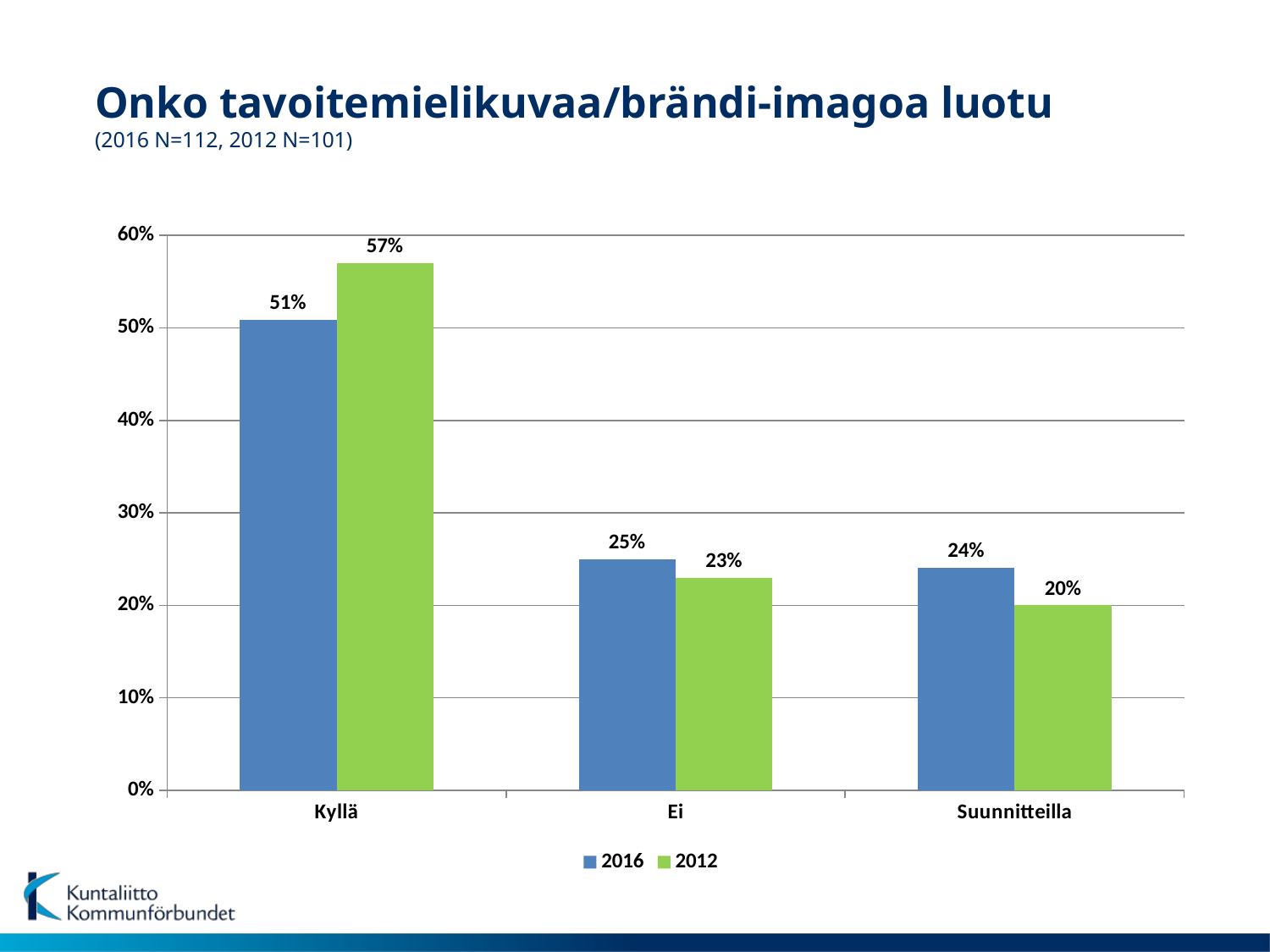
What is the value for Suunnitteilla in the 2012 series? 20% What is the value for Ei in the 2016 series? 25% Which category has the highest value in the 2016 series? Kyllä What is the value for Kyllä in the 2016 series? 51% How many categories are shown on the x axis? 3 What is the difference between the 2012 and 2016 values for Kyllä? 6% What kind of chart is shown on the slide? Bar chart What is the difference between the 2016 and 2012 values for Suunnitteilla? 4% What is the value for Kyllä in the 2012 series? 57% How many series does the legend list? 2 Which category has the lowest value in the 2012 series? Suunnitteilla Which is larger for Ei: the 2016 value or the 2012 value? 2016